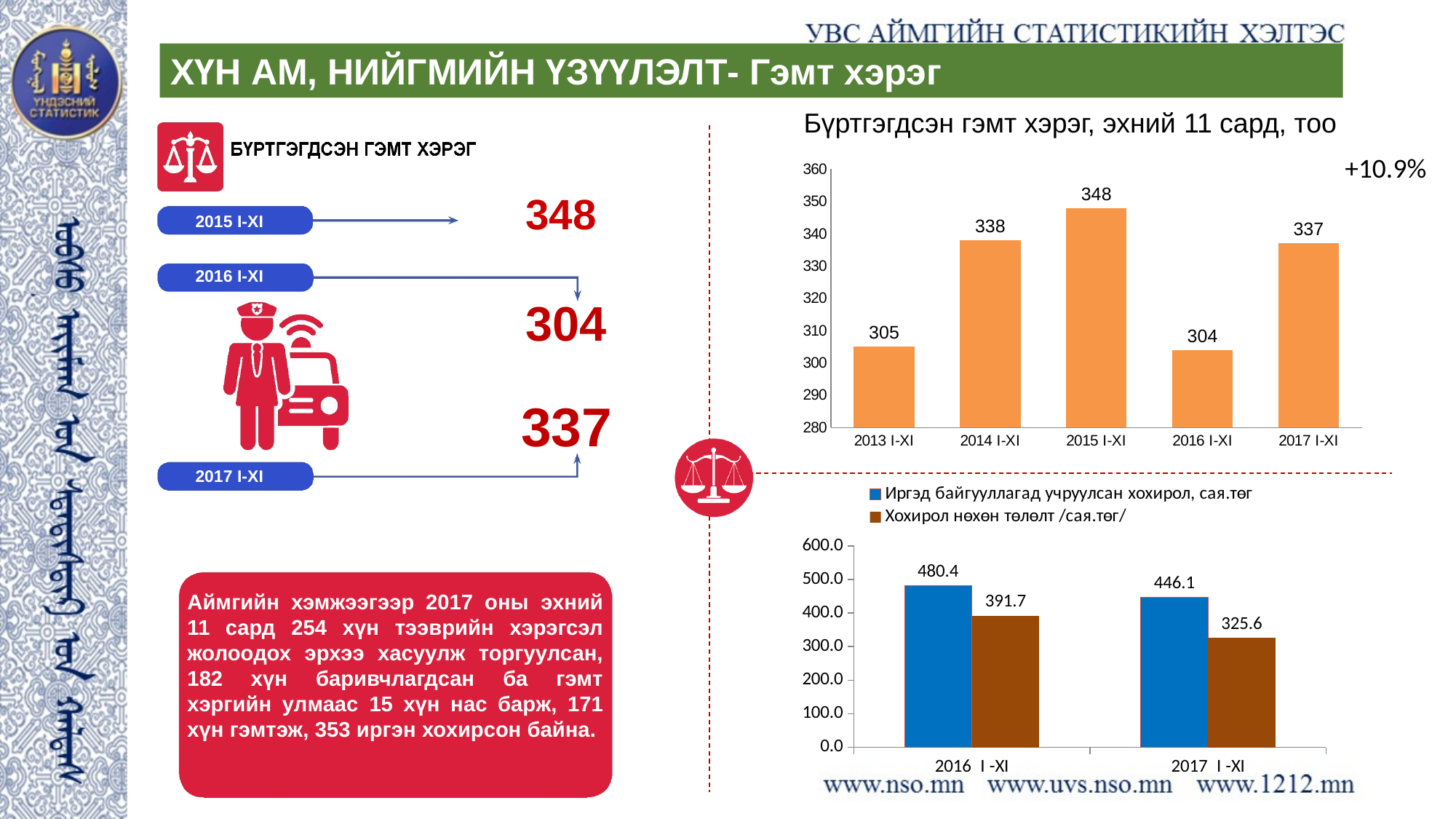
In the top chart 'Бүртгэгдсэн гэмт хэрэг, эхний 11 сард, тоо', which year has the highest value? 2015 I-XI In the bottom chart, how many series does the legend list? 2 In the bottom chart, what is the difference between 'Иргэд байгууллагад учруулсан хохирол, сая.төг' for 2016 I-XI and 2017 I-XI? 34.3 In the bottom chart, what is the value of 'Хохирол нөхөн төлөлт /сая.төг/' for 2016 I-XI? 391.7 In the top chart 'Бүртгэгдсэн гэмт хэрэг, эхний 11 сард, тоо', how many years are shown on the x axis? 5 In the top chart 'Бүртгэгдсэн гэмт хэрэг, эхний 11 сард, тоо', what is the value for 2014 I-XI? 338 In the top chart 'Бүртгэгдсэн гэмт хэрэг, эхний 11 сард, тоо', which year has the lowest value? 2016 I-XI In the bottom chart, what is the value of 'Иргэд байгууллагад учруулсан хохирол, сая.төг' for 2017 I-XI? 446.1 In the bottom chart, which is larger: 'Хохирол нөхөн төлөлт /сая.төг/' for 2016 I-XI or for 2017 I-XI? 2016 I-XI In the top chart 'Бүртгэгдсэн гэмт хэрэг, эхний 11 сард, тоо', what is the difference between the values for 2017 I-XI and 2016 I-XI? 33 What type of chart is the top chart 'Бүртгэгдсэн гэмт хэрэг, эхний 11 сард, тоо'? Bar chart In the top chart 'Бүртгэгдсэн гэмт хэрэг, эхний 11 сард, тоо', is the value for 2013 I-XI greater or less than 310? less